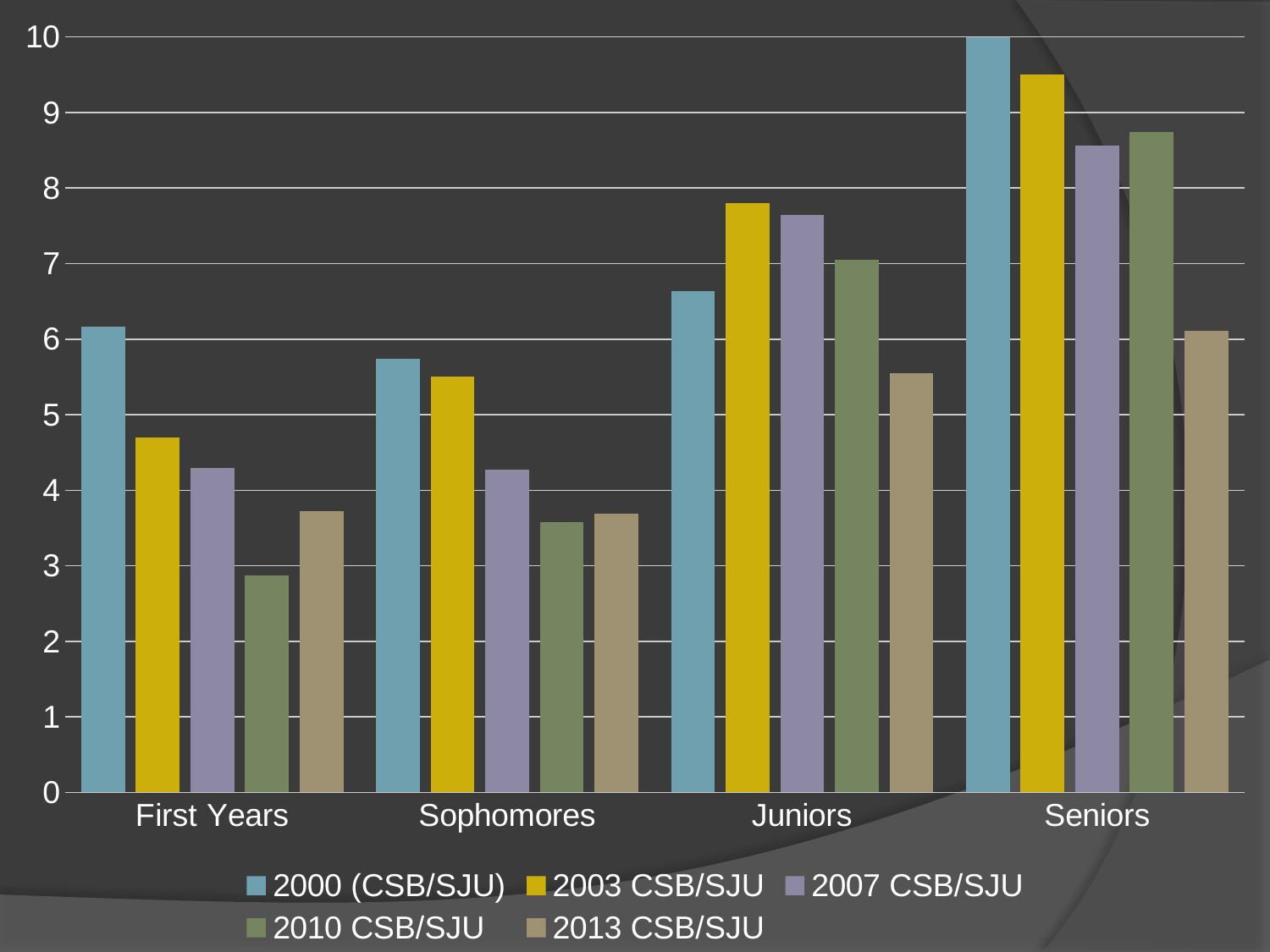
Which series has the lowest value for Seniors? 2013 CSB/SJU What kind of chart is shown on the slide? bar chart How many series does the legend list? 5 Is the value for Juniors in the 2013 CSB/SJU series greater or less than 5? greater For First Years, which is larger: the 2000 (CSB/SJU) value or the 2003 CSB/SJU value? 2000 (CSB/SJU) Is the value for First Years in the 2010 CSB/SJU series greater or less than 3? less Which category has the highest value for the 2000 (CSB/SJU) series? Seniors How many categories are shown on the x axis? 4 Is the value for Seniors in the 2003 CSB/SJU series greater or less than 9? greater Which series is shown in yellow? 2003 CSB/SJU Which series has the highest value for Juniors? 2003 CSB/SJU Which category has the lowest value for the 2010 CSB/SJU series? First Years